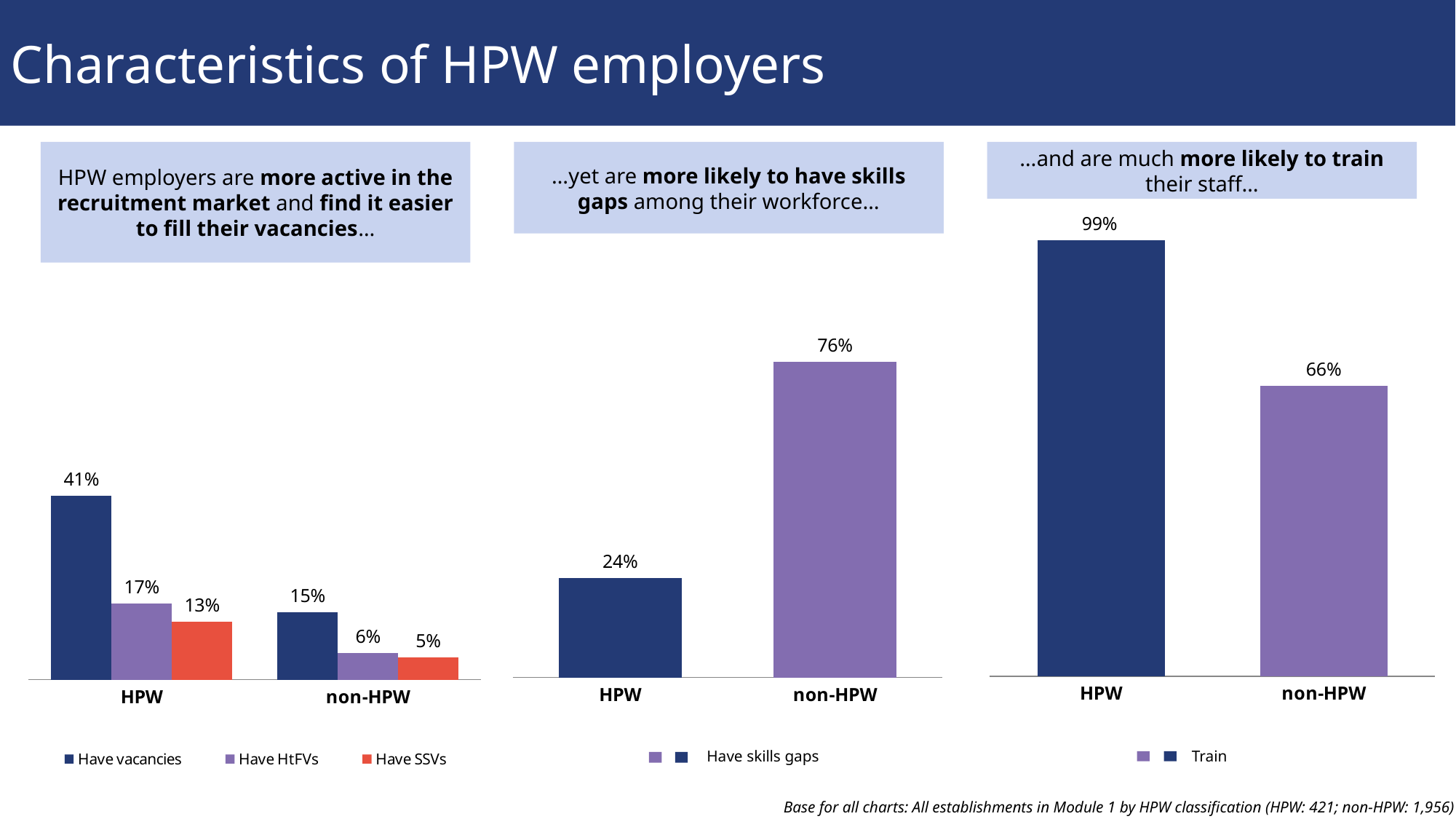
In the right chart, what percentage of HPW employers train their staff? 99% In the left chart, which series has the lowest value for non-HPW employers? Have SSVs In the middle chart, what percentage of non-HPW employers have skills gaps? 76% In the middle chart, what is the difference between the non-HPW and HPW values for having skills gaps? 52% In the right chart, what is the difference between the HPW and non-HPW values for training? 33% In the left chart, what is the difference between the share of HPW and non-HPW employers that have SSVs? 8% In the middle chart, which group has the higher share with skills gaps, HPW or non-HPW? non-HPW How many categories are shown on the x axis of the middle chart? 2 In the left chart, what percentage of non-HPW employers have HtFVs? 6% In the left chart, what percentage of HPW employers have vacancies? 41% In the left chart, how many series does the legend list? 3 What type of chart is the right chart? bar chart